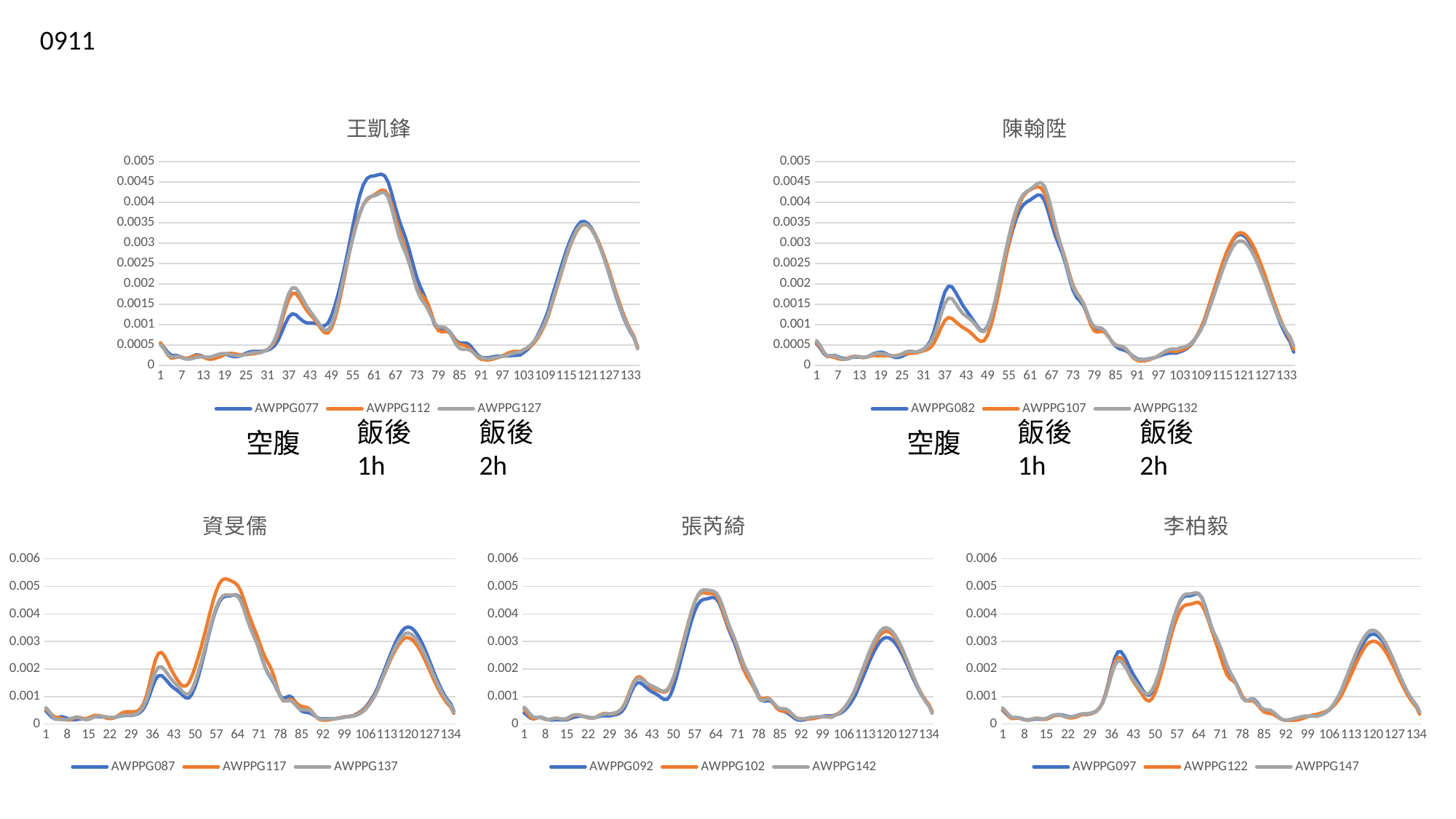
In the chart titled 陳翰陞, around x=37, which series is higher: AWPPG082 or AWPPG107? AWPPG082 In the chart titled 王凱鋒, is the peak value of AWPPG077 around x=61 greater or less than 0.004? greater In the chart titled 資旻儒, is the peak value of AWPPG117 around x=60 greater or less than 0.005? greater What are the legend entries of the chart titled 陳翰陞? AWPPG082, AWPPG107, AWPPG132 What kind of chart is the chart titled 王凱鋒? line chart How many charts are shown on the slide? 5 How many series does the legend of the chart titled 王凱鋒 list? 3 What is the highest y-axis tick shown on the chart titled 資旻儒? 0.006 In the chart titled 王凱鋒, which of the three peaks is the highest: the first (around x=37), the second (around x=61) or the third (around x=121)? the second (around x=61) In the chart titled 張芮綺, is the highest peak around x=60 greater or less than 0.004? greater In the chart titled 李柏毅, around x=120, which series is higher: AWPPG147 or AWPPG122? AWPPG147